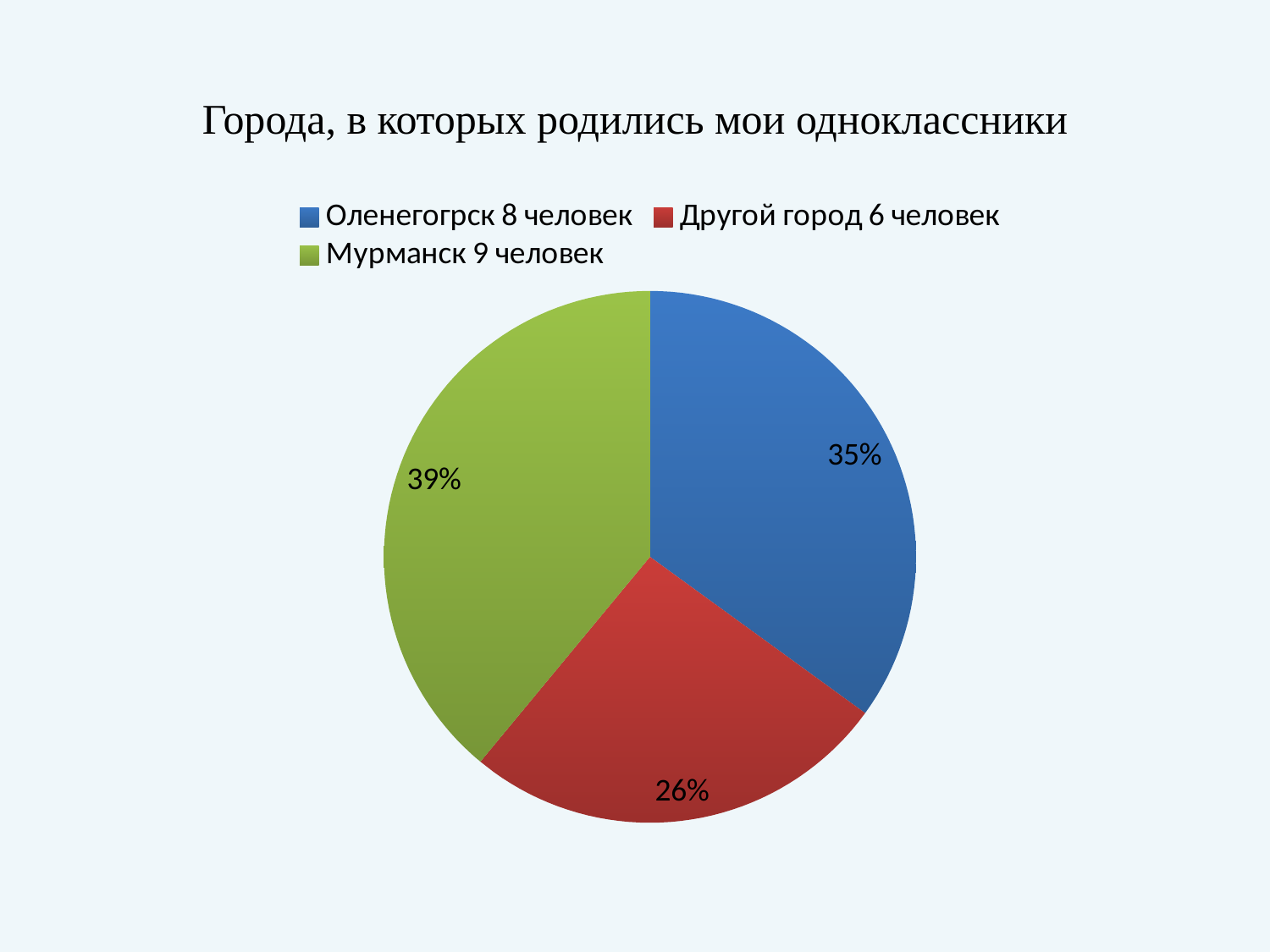
Which slice has the largest share of the pie? Мурманск 9 человек What type of chart is shown on the slide? pie chart How many entries does the legend list? 3 Which slice has the smallest share of the pie? Другой город 6 человек What is the difference in percentage points between the 'Мурманск 9 человек' slice and the 'Другой город 6 человек' slice? 13 How many slices does the pie chart have? 3 What colour is the slice for 'Мурманск 9 человек'? green What percentage share is shown for the slice 'Оленегогрск 8 человек'? 35% What percentage share is shown for the slice 'Мурманск 9 человек'? 39% What is the title of the chart? Города, в которых родились мои одноклассники Which slice is larger: 'Оленегогрск 8 человек' or 'Другой город 6 человек'? Оленегогрск 8 человек What percentage share is shown for the slice 'Другой город 6 человек'? 26%